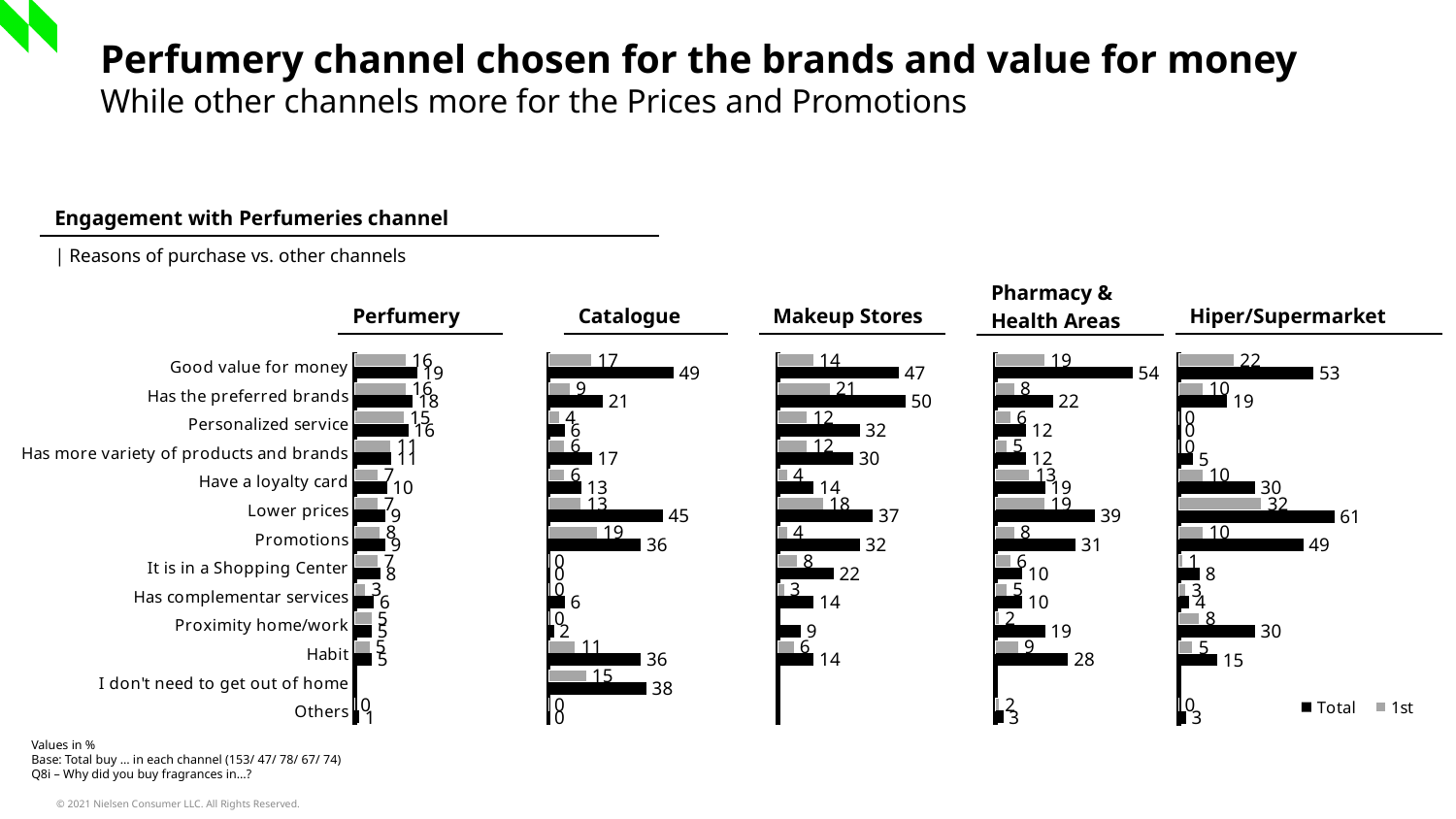
In the Makeup Stores chart, what is the Total value for Promotions? 32 In the Catalogue chart, what is the Total value for Good value for money? 49 In the Hiper/Supermarket chart, what is the Total value for Lower prices? 61 In the Catalogue chart, what is the difference between the Total values for Good value for money and Lower prices? 4 How many series does the legend list? 2 In the Perfumery chart, what is the Total value for Has the preferred brands? 18 What kind of chart is used for the Makeup Stores data? Bar chart In the Makeup Stores chart, which category has the highest Total value? Has the preferred brands In the Hiper/Supermarket chart, which category has the highest Total value? Lower prices In the Pharmacy & Health Areas chart, which is larger, the Total value for Good value for money or the Total value for Lower prices? Good value for money In the Pharmacy & Health Areas chart, what is the 1st value for Good value for money? 19 What are the two series named in the legend? Total and 1st